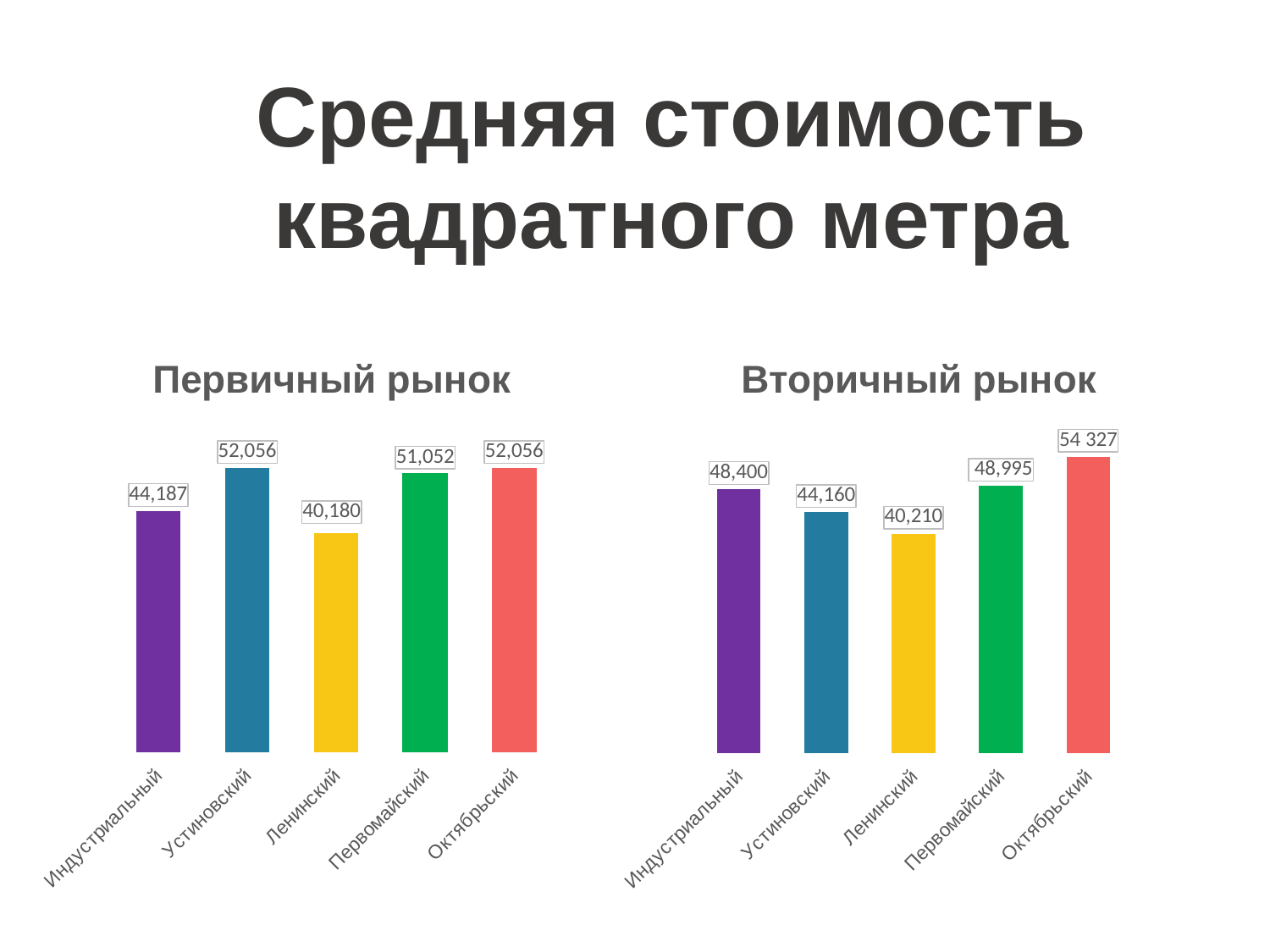
In the Вторичный рынок chart, what is the value for Устиновский? 44,160 In the Вторичный рынок chart, what is the value for Октябрьский? 54 327 In the Вторичный рынок chart, which category has the highest value? Октябрьский What kind of chart is the Вторичный рынок chart? Bar chart In the Вторичный рынок chart, which is larger: Индустриальный or Устиновский? Индустриальный In the Первичный рынок chart, what is the difference between the values for Устиновский and Индустриальный? 7,869 In the Первичный рынок chart, what is the value for Первомайский? 51,052 In the Вторичный рынок chart, which category has the lowest value? Ленинский In the Первичный рынок chart, what is the value for Индустриальный? 44,187 In the Первичный рынок chart, which category has the lowest value? Ленинский How many categories are shown in the Первичный рынок chart? 5 In the Вторичный рынок chart, what is the difference between the values for Октябрьский and Ленинский? 14,117